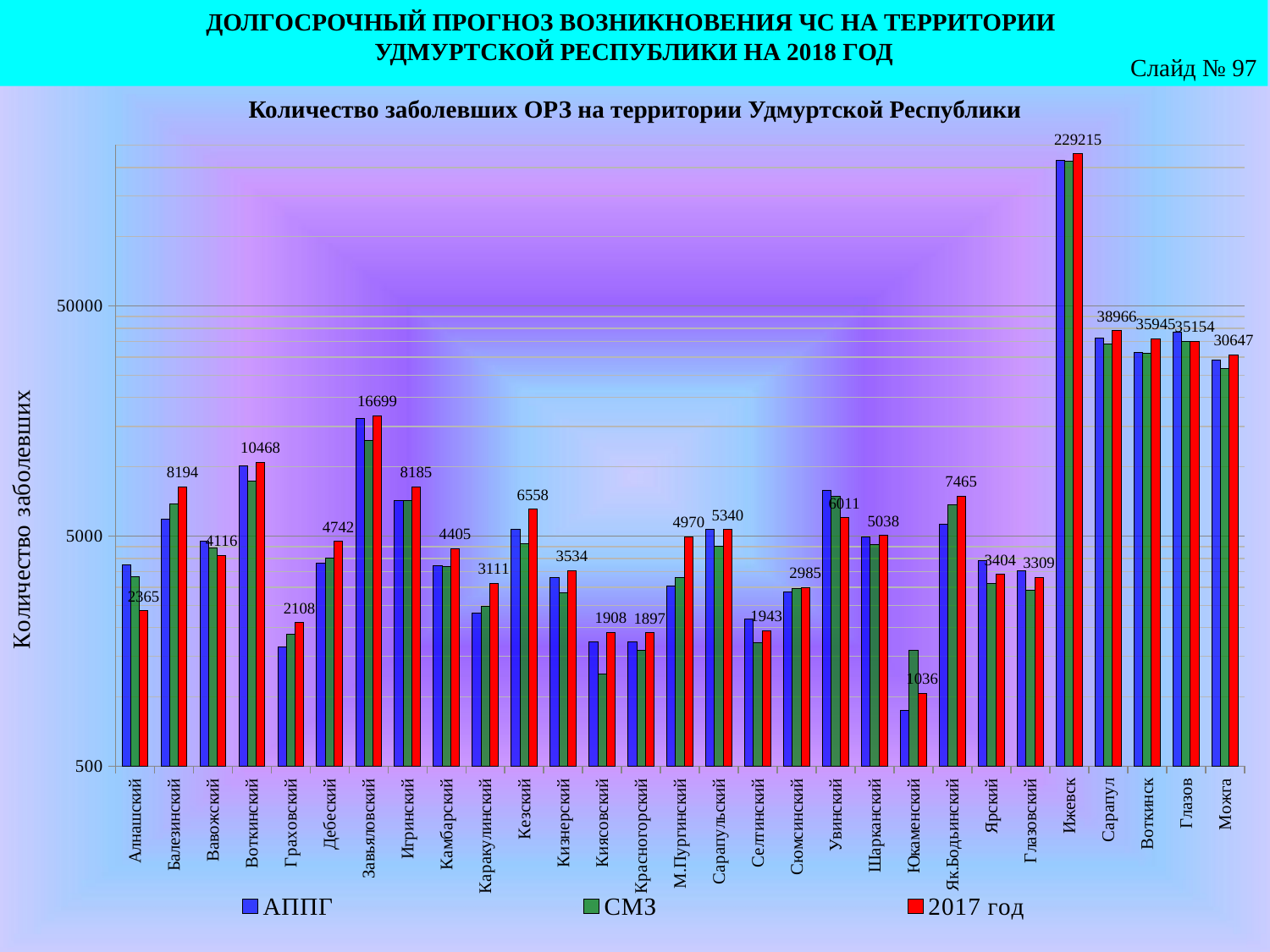
Which is larger in the 2017 год series: Балезинский or Игринский? Балезинский What is the difference between the 2017 год values for Сарапул and Воткинск? 3021 What is the value for Ижевск in the 2017 год series? 229215 Which category has the lowest value in the 2017 год series? Юкаменский How many series does the legend list? 3 What is the title of the chart? Количество заболевших ОРЗ на территории Удмуртской Республики What is the value for Юкаменский in the 2017 год series? 1036 How many categories are shown on the x axis? 29 What is the value for Завьяловский in the 2017 год series? 16699 What kind of chart is shown on the slide? bar chart Is the АППГ value for Ижевск greater or less than 50000? greater Which category has the highest value in the 2017 год series? Ижевск